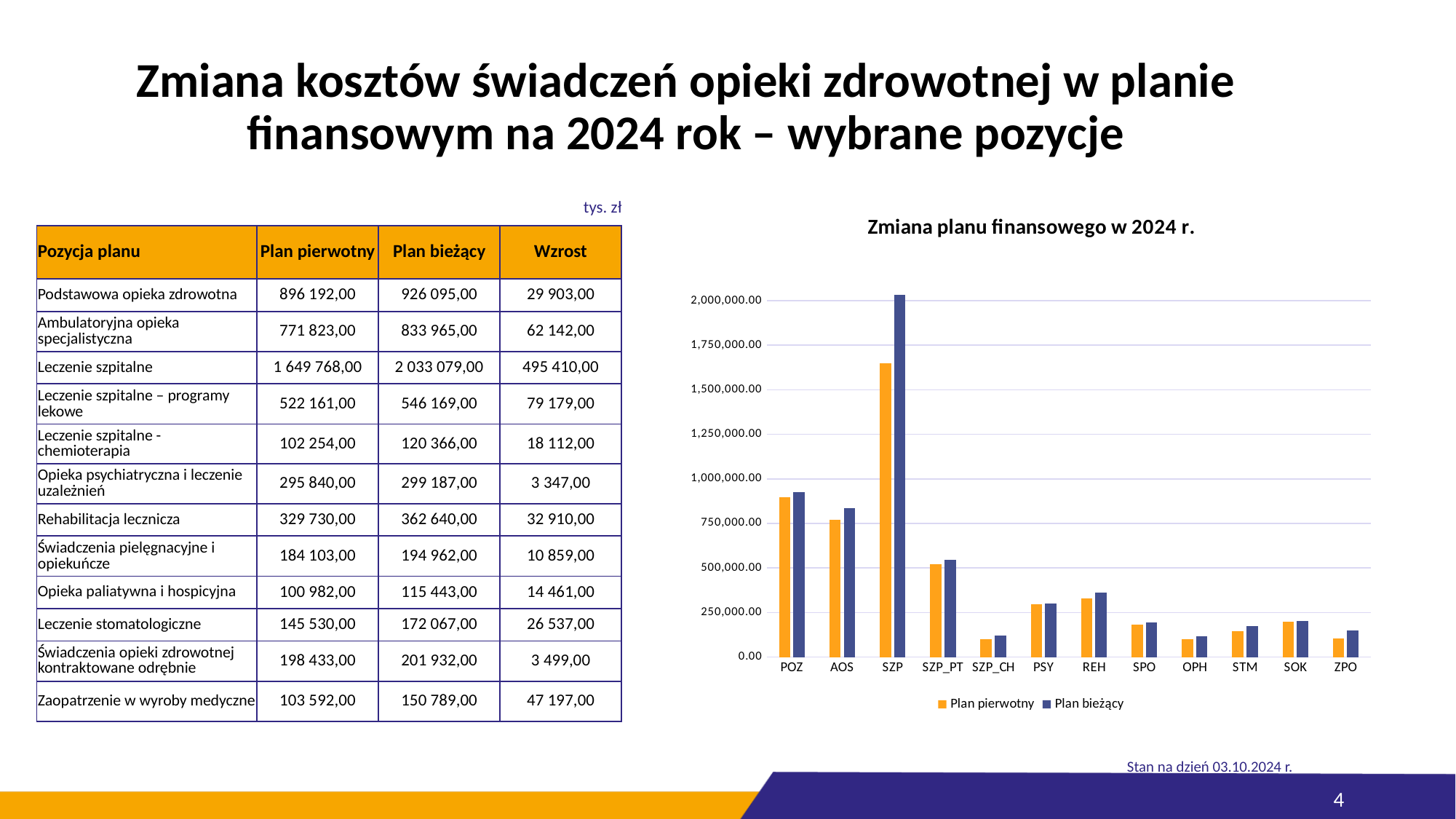
What kind of chart is shown on the slide? bar chart Which is larger for Plan pierwotny: POZ or AOS? POZ Is the Plan pierwotny value for SZP greater or less than 1,500,000.00? greater How many categories are shown on the x axis of the chart? 12 What colour are the Plan pierwotny bars in the chart? orange Which is larger for Plan bieżący: REH or PSY? REH Is the Plan bieżący value for AOS greater or less than 750,000.00? greater Which category has the highest value for Plan bieżący? SZP What is the title of the chart? Zmiana planu finansowego w 2024 r. Is the Plan bieżący value for SPO greater or less than 250,000.00? less How many series does the chart legend list? 2